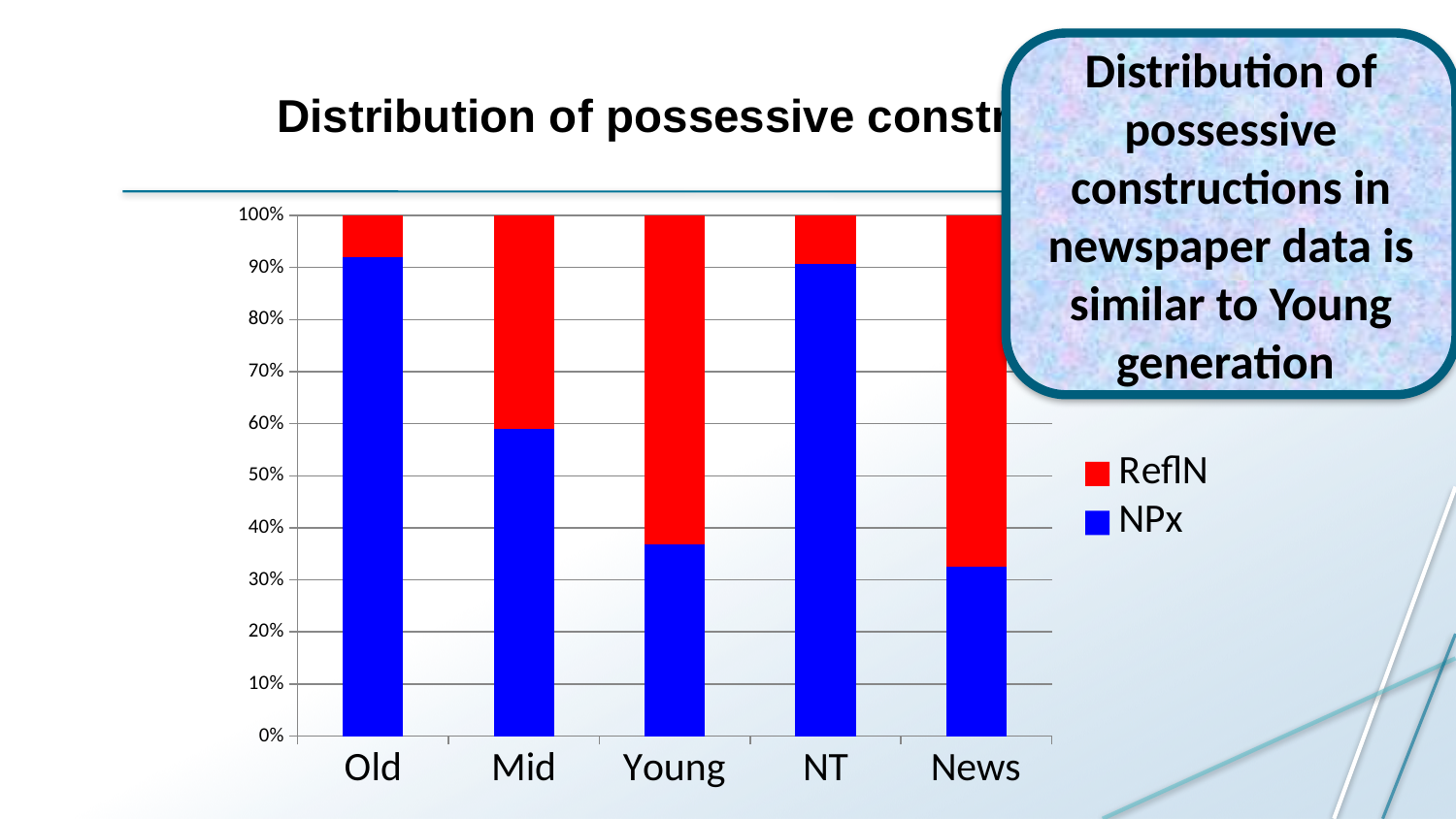
How many categories are shown on the x axis of the chart? 5 Which has a larger NPx share, Old or Mid? Old Is the NPx value for Mid greater or less than 50%? greater Which series is shown in blue in the chart? NPx Which series is shown in red in the chart? ReflN Is the NPx value for News greater or less than 40%? less How many series does the chart legend list? 2 Is the NPx value for Young greater or less than 40%? less What is the total of the stacked bar for Young? 100% What kind of chart is shown on the slide? Stacked bar chart